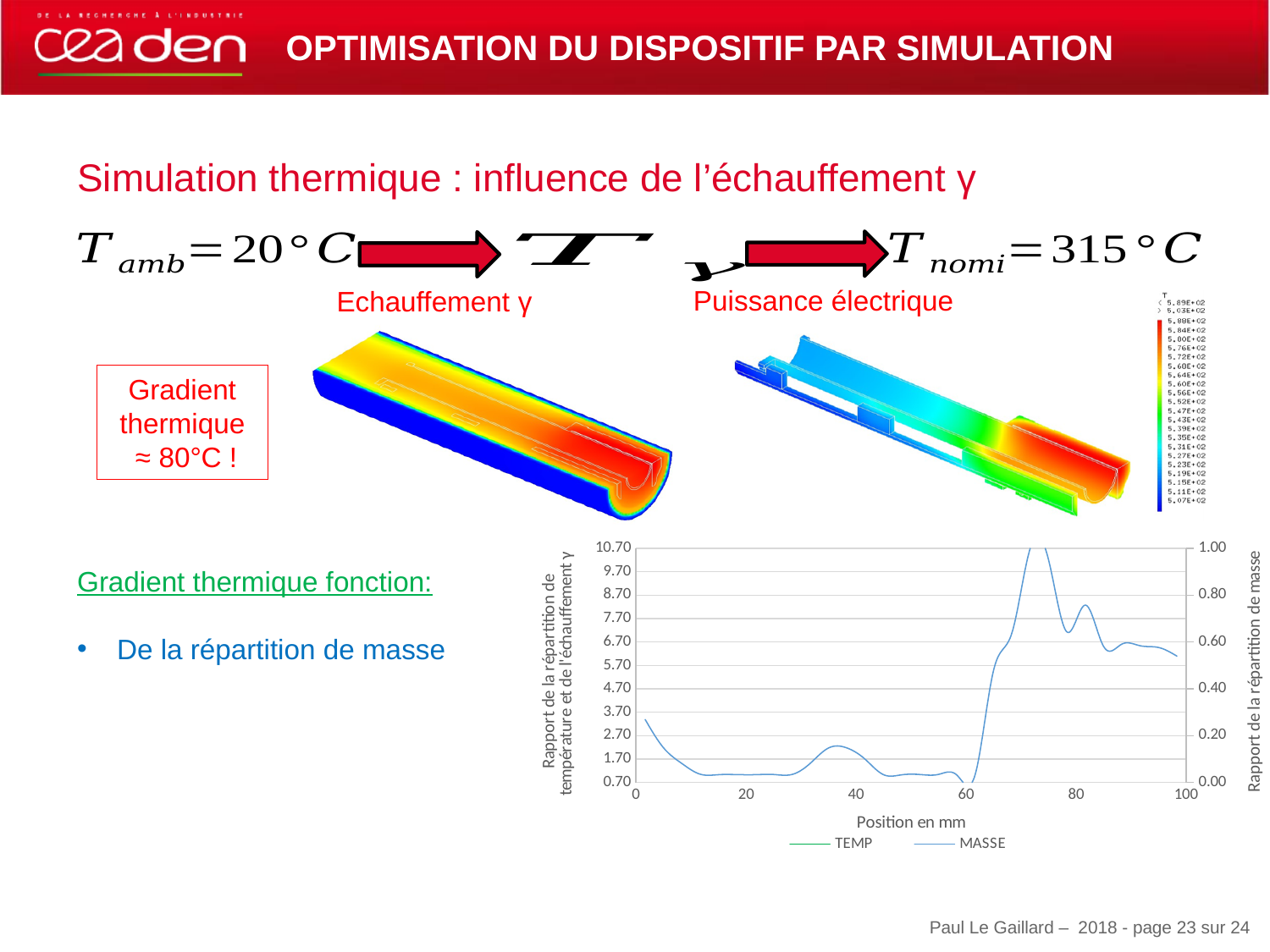
In the line chart, does the line rise or fall between positions 0 mm and 10 mm? fall What is the title of the x axis of the line chart? Position en mm In the line chart, is the value of the line at position 50 mm greater or less than 2.70 on the left axis? less In the line chart, is the peak value of the line near position 73 mm greater or less than 8.70 on the left axis? greater In the line chart, is the value of the line at position 20 mm greater or less than 1.70 on the left axis? less In the line chart, is the value at position 73 mm larger or smaller than the value at position 37 mm? larger What kind of chart is shown at the bottom right of the slide? line chart What is the lowest tick value shown on the left y axis of the line chart? 0.70 In the line chart, does the line rise or fall between positions 60 mm and 73 mm? rise How many series does the legend of the line chart list? 2 What are the two series named in the legend of the line chart? TEMP and MASSE What is the highest tick value shown on the right y axis of the line chart? 1.00